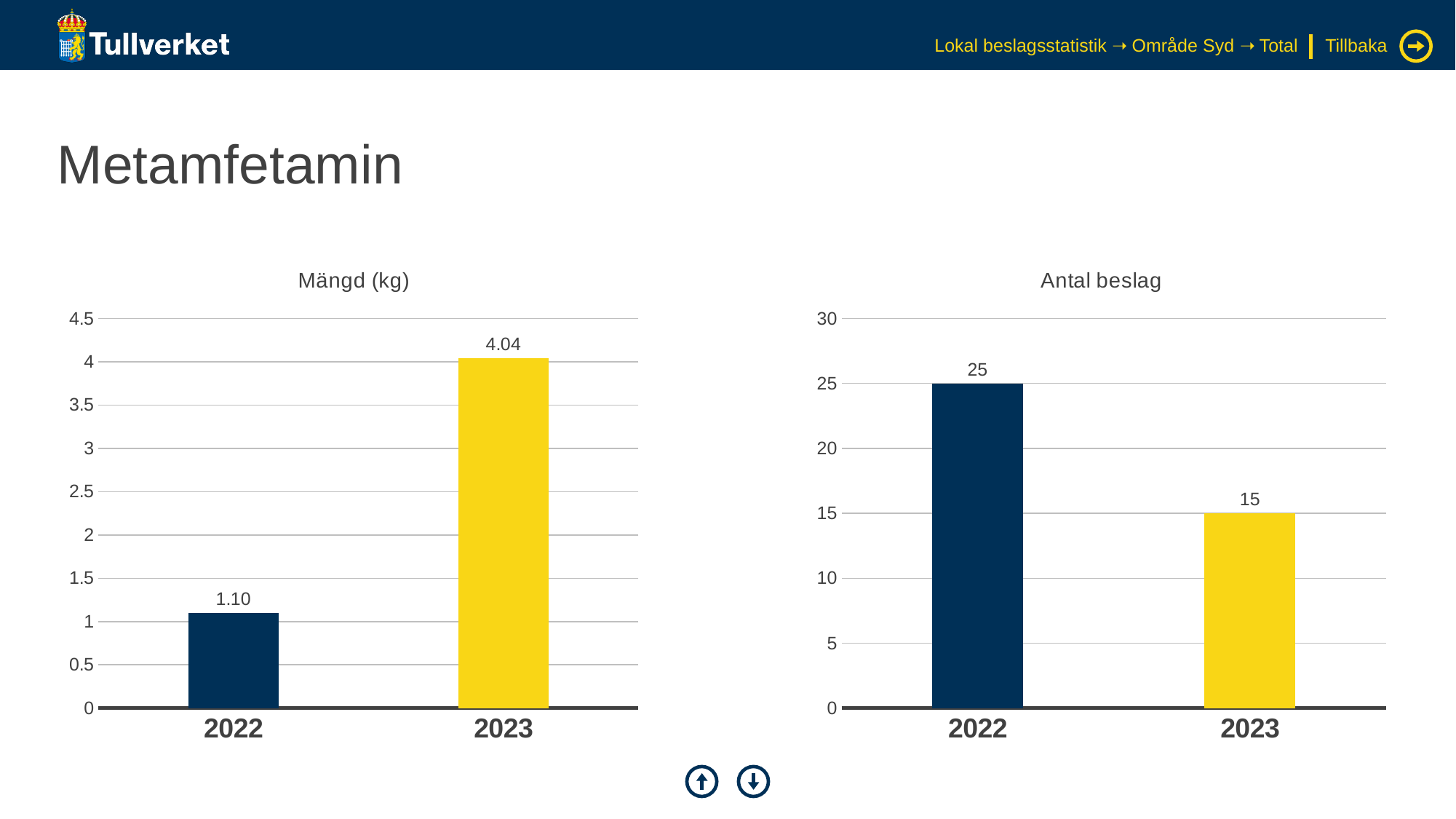
In the 'Antal beslag' chart, is the value for 2022 greater or less than 20? greater What kind of chart is the 'Antal beslag' chart? bar chart In the 'Antal beslag' chart, what is the value for 2023? 15 In the 'Mängd (kg)' chart, what is the value for 2023? 4.04 In the 'Mängd (kg)' chart, what is the difference between the values for 2023 and 2022? 2.94 In the 'Mängd (kg)' chart, which year has the highest value? 2023 In the 'Antal beslag' chart, what is the difference between the values for 2022 and 2023? 10 In the 'Mängd (kg)' chart, how many categories are shown on the x axis? 2 In the 'Mängd (kg)' chart, what is the value for 2022? 1.10 In the 'Antal beslag' chart, which year has the lowest value? 2023 In the 'Antal beslag' chart, do the values rise or fall from 2022 to 2023? fall In the 'Antal beslag' chart, what is the value for 2022? 25